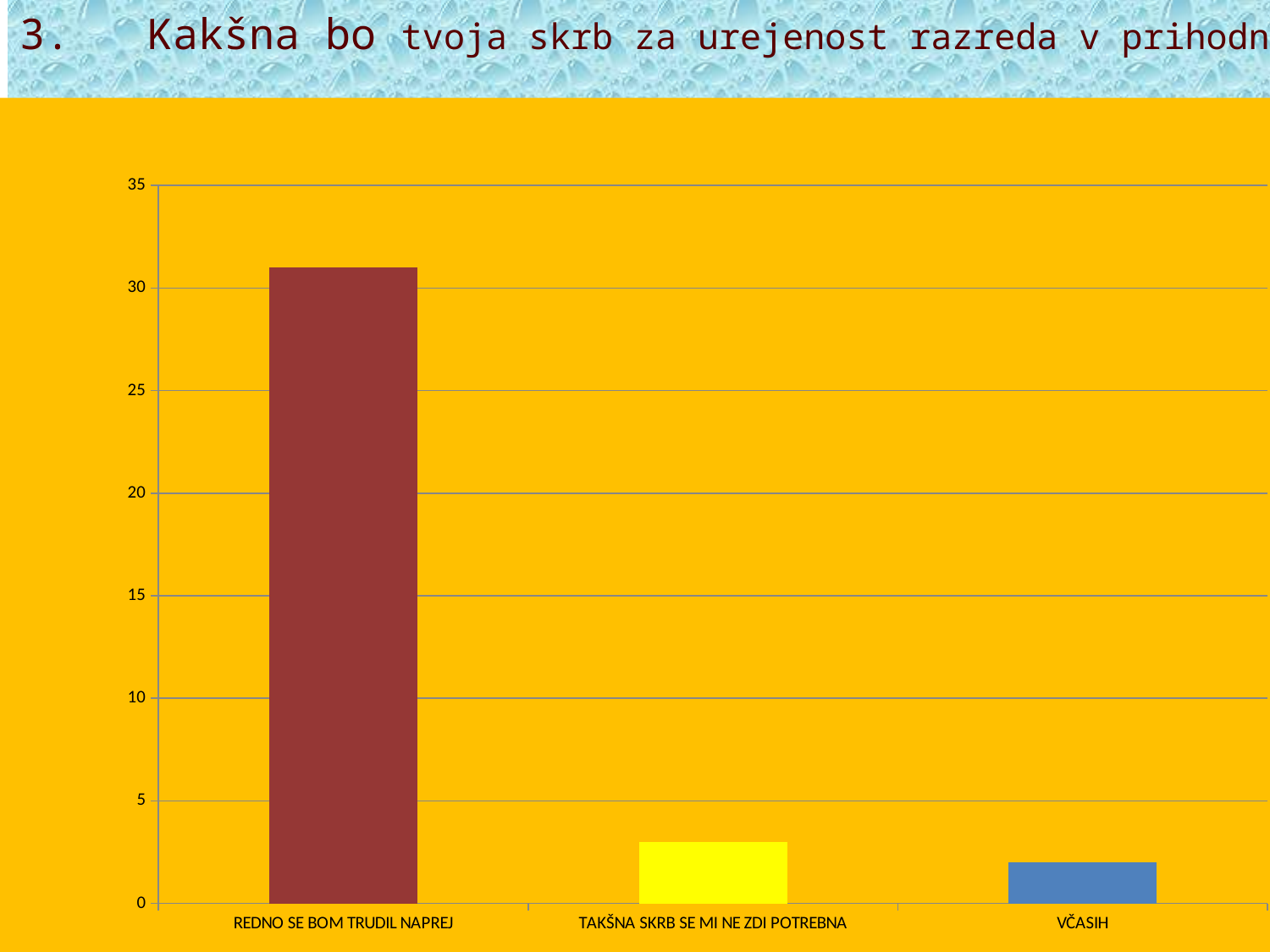
Is the value for VČASIH greater or less than 5? less Which is larger, the value for TAKŠNA SKRB SE MI NE ZDI POTREBNA or the value for VČASIH? TAKŠNA SKRB SE MI NE ZDI POTREBNA How many categories are shown on the x axis of the chart? 3 Which is larger, the value for REDNO SE BOM TRUDIL NAPREJ or the value for VČASIH? REDNO SE BOM TRUDIL NAPREJ What is the highest value shown on the vertical axis of the chart? 35 Which category has the highest bar in the chart? REDNO SE BOM TRUDIL NAPREJ Which category has the lowest bar in the chart? VČASIH Is the value for TAKŠNA SKRB SE MI NE ZDI POTREBNA greater or less than 5? less What kind of chart is shown on the slide? bar chart Is the value for REDNO SE BOM TRUDIL NAPREJ greater or less than 35? less What colour is the bar for VČASIH? blue